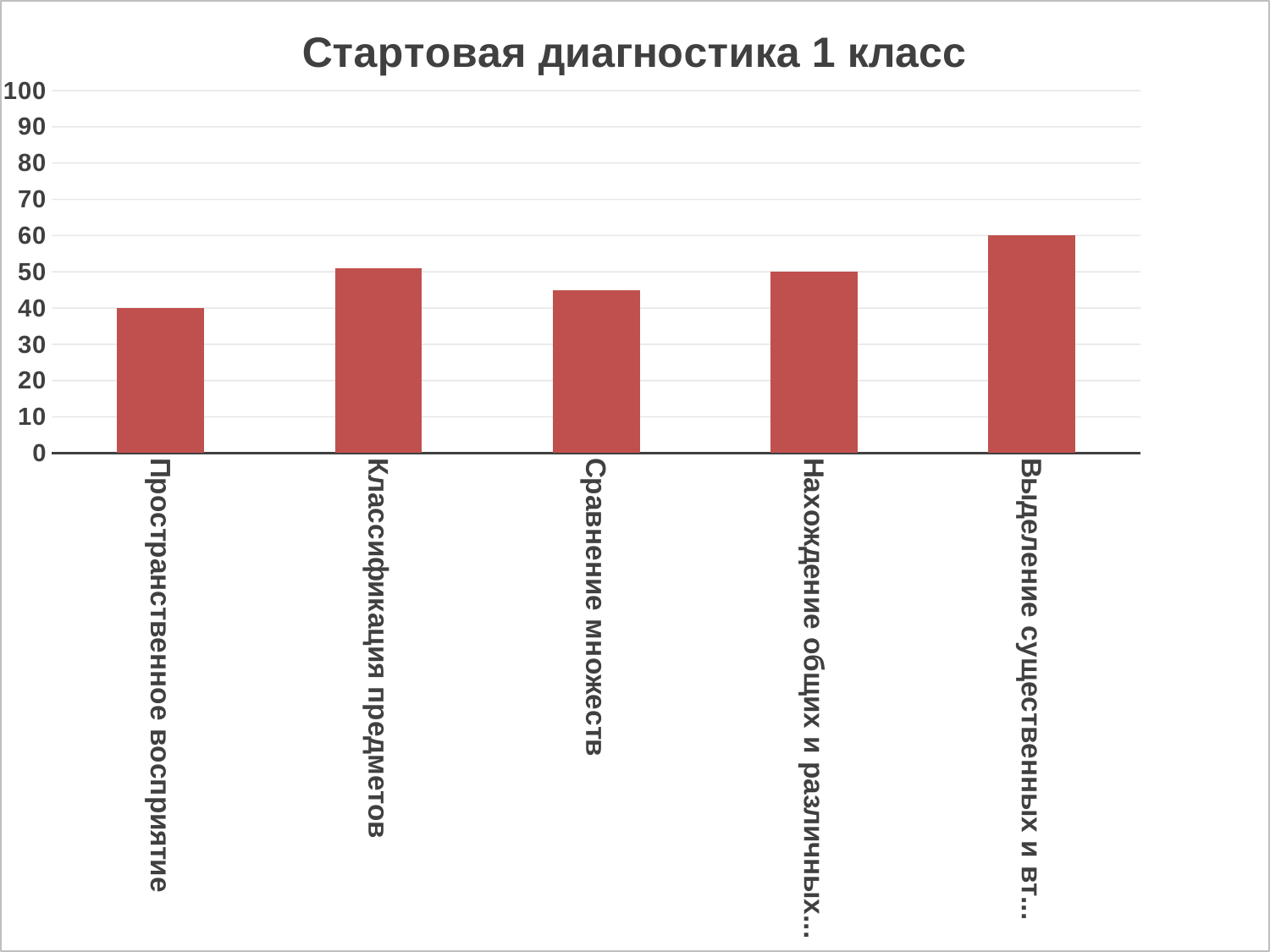
What is the value for Нахождение общих и различных...? 50 Is the value for Сравнение множеств greater or less than 50? less What is the difference between the value for Выделение существенных и вт... and the value for Пространственное восприятие? 20 What is the value for Пространственное восприятие? 40 Is the value for Классификация предметов greater or less than 40? greater What is the value for Выделение существенных и вт...? 60 Which is larger, the value for Классификация предметов or the value for Сравнение множеств? Классификация предметов What kind of chart is shown on the slide? bar chart How many categories are shown on the x axis? 5 Which category has the highest value? Выделение существенных и вт... Which category has the lowest value? Пространственное восприятие What is the title of the chart? Стартовая диагностика 1 класс